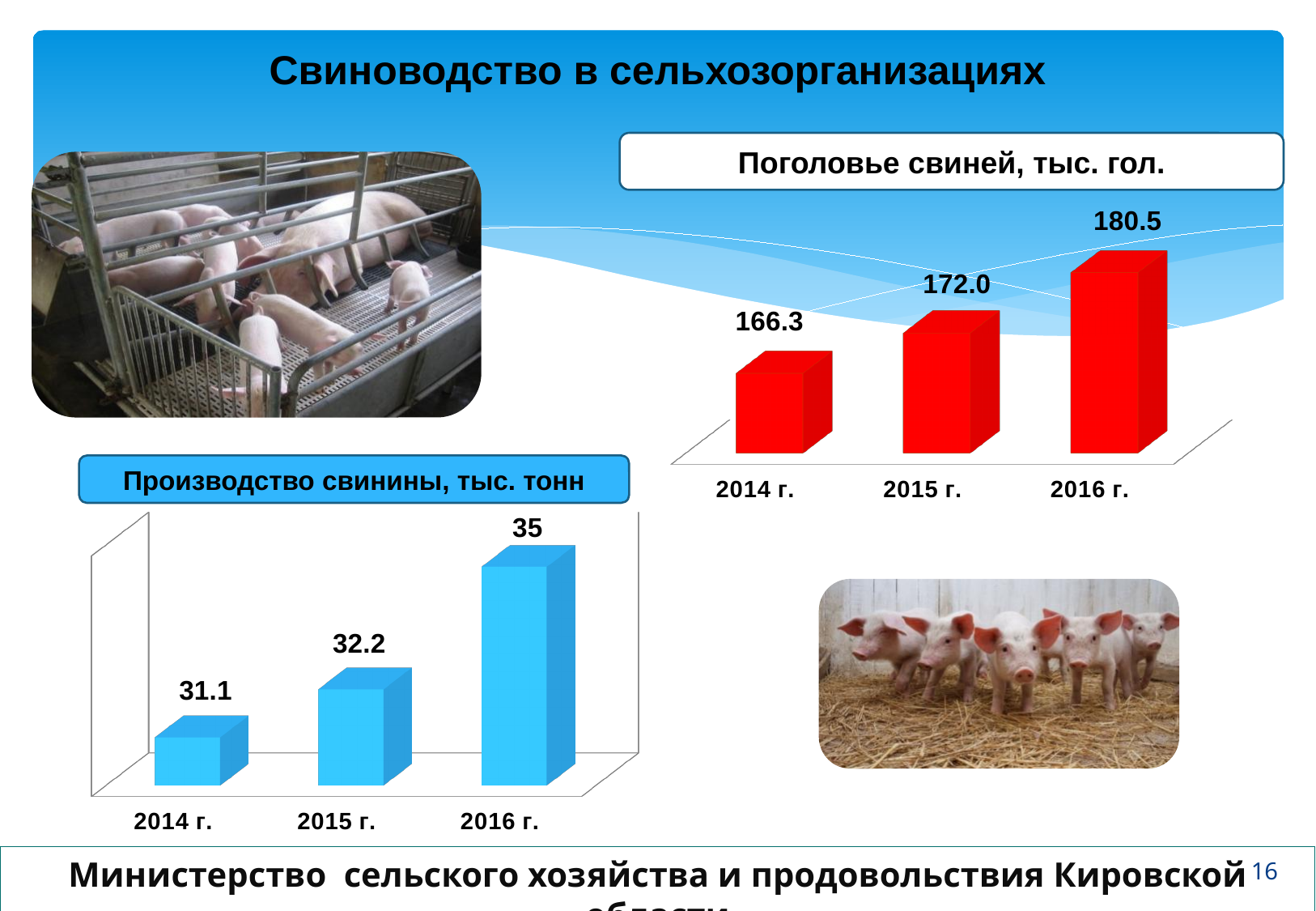
In the chart 'Поголовье свиней, тыс. гол.', what is the value for 2015 г.? 172.0 In the chart 'Производство свинины, тыс. тонн', what is the value for 2016 г.? 35 In the chart 'Производство свинины, тыс. тонн', which is larger, the value for 2015 г. or 2016 г.? 2016 г. In the chart 'Поголовье свиней, тыс. гол.', what is the difference between the values for 2016 г. and 2014 г.? 14.2 In the chart 'Поголовье свиней, тыс. гол.', do the values rise or fall from 2014 г. to 2016 г.? rise In the chart 'Поголовье свиней, тыс. гол.', which year has the highest value? 2016 г. In the chart 'Поголовье свиней, тыс. гол.', how many bars are plotted? 3 In the chart 'Производство свинины, тыс. тонн', what is the value for 2014 г.? 31.1 In the chart 'Производство свинины, тыс. тонн', what is the difference between the values for 2015 г. and 2014 г.? 1.1 What colour are the bars in the chart 'Поголовье свиней, тыс. гол.'? red In the chart 'Производство свинины, тыс. тонн', which year has the lowest value? 2014 г. What kind of chart is 'Производство свинины, тыс. тонн'? bar chart